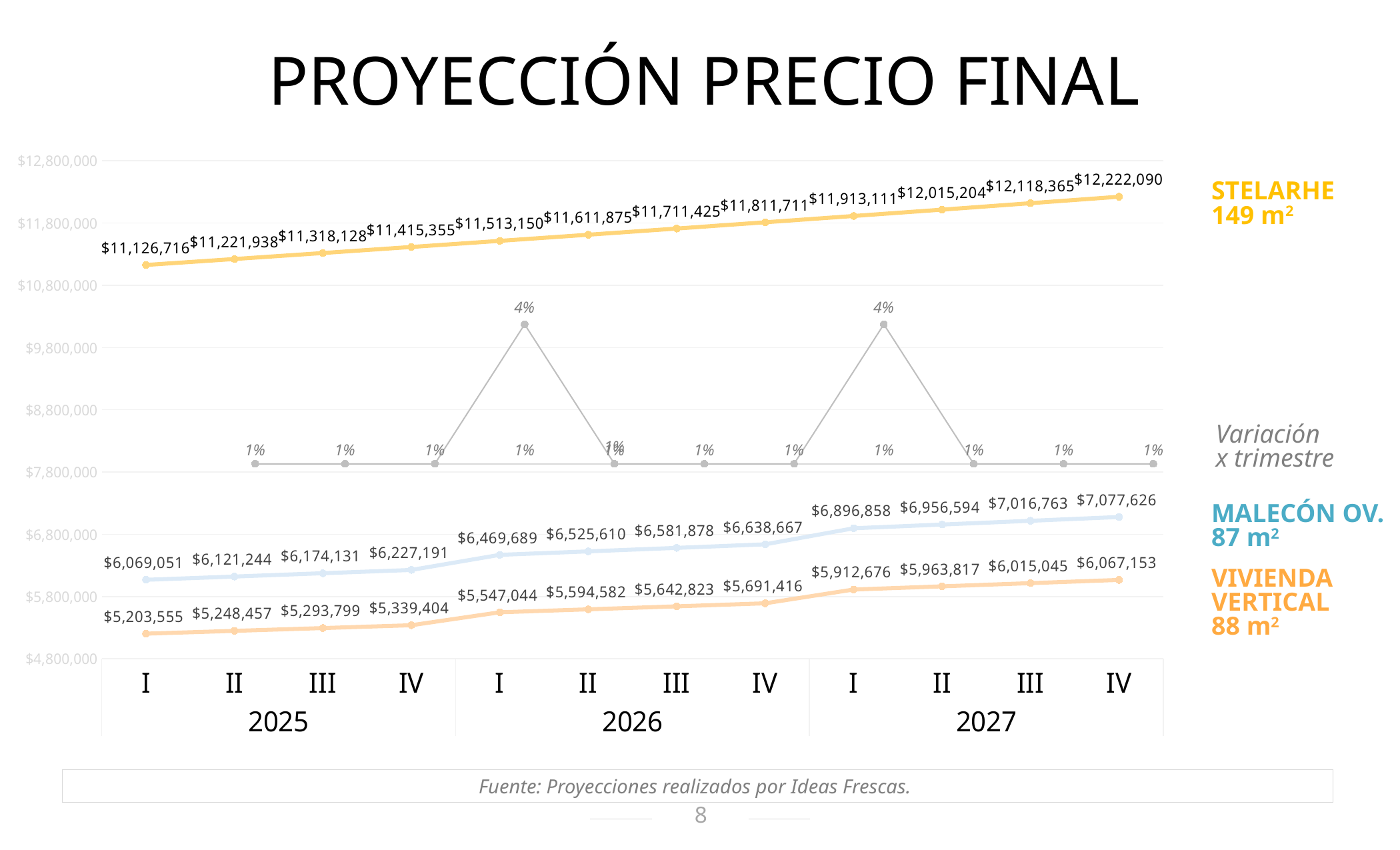
What is the difference between the STELARHE price in quarter IV of 2027 and in quarter I of 2025? $1,095,374 What is the difference between the VIVIENDA VERTICAL price in quarter I of 2026 and quarter IV of 2025? $207,640 Do the STELARHE prices rise or fall from 2025 to 2027? Rise How many quarters are plotted along the x axis? 12 What type of chart is shown on the slide? Line chart What is the projected final price for VIVIENDA VERTICAL in quarter I of 2026? $5,547,044 What is the projected final price for MALECÓN OV. in quarter IV of 2027? $7,077,626 Which series has the highest projected price in quarter IV of 2027? STELARHE What is the projected final price for STELARHE in quarter I of 2025? $11,126,716 Which series has the lowest projected price in quarter I of 2025? VIVIENDA VERTICAL Which is larger: the MALECÓN OV. price in quarter IV of 2027 or the VIVIENDA VERTICAL price in quarter IV of 2027? MALECÓN OV.